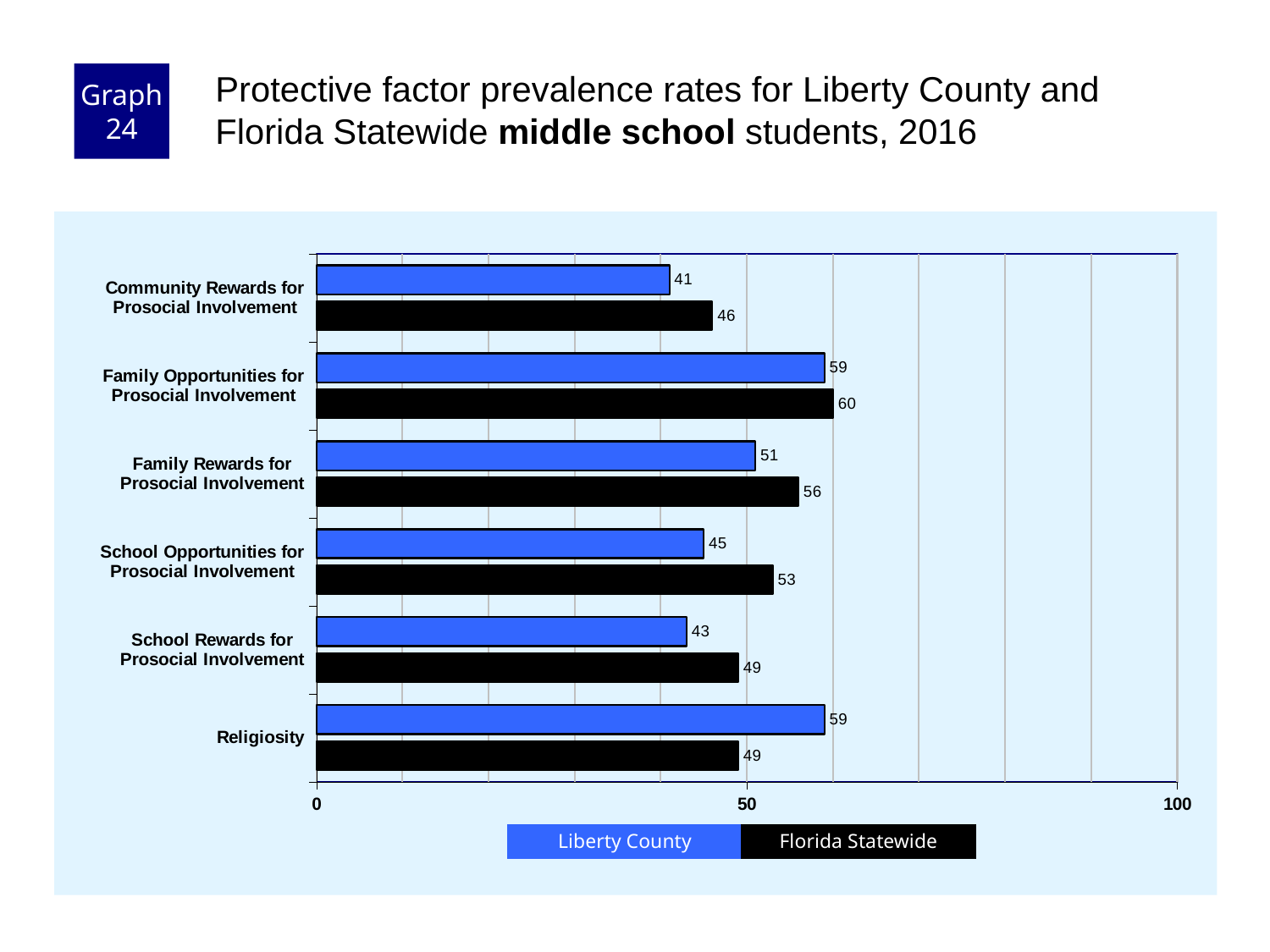
What is the difference between the Florida Statewide and Liberty County values for School Opportunities for Prosocial Involvement? 8 Is the Liberty County value for Family Rewards for Prosocial Involvement greater or less than 50? greater What is the Florida Statewide value for School Opportunities for Prosocial Involvement? 53 Which category has the lowest Liberty County value? Community Rewards for Prosocial Involvement How many series does the legend list? 2 How many protective factor categories are shown on the chart? 6 What is the Liberty County value for Community Rewards for Prosocial Involvement? 41 Which category has the highest Florida Statewide value? Family Opportunities for Prosocial Involvement What is the Florida Statewide value for Religiosity? 49 Which colour represents Florida Statewide in the chart? black For Religiosity, which is larger: the Liberty County value or the Florida Statewide value? Liberty County What kind of chart is shown on the slide? bar chart